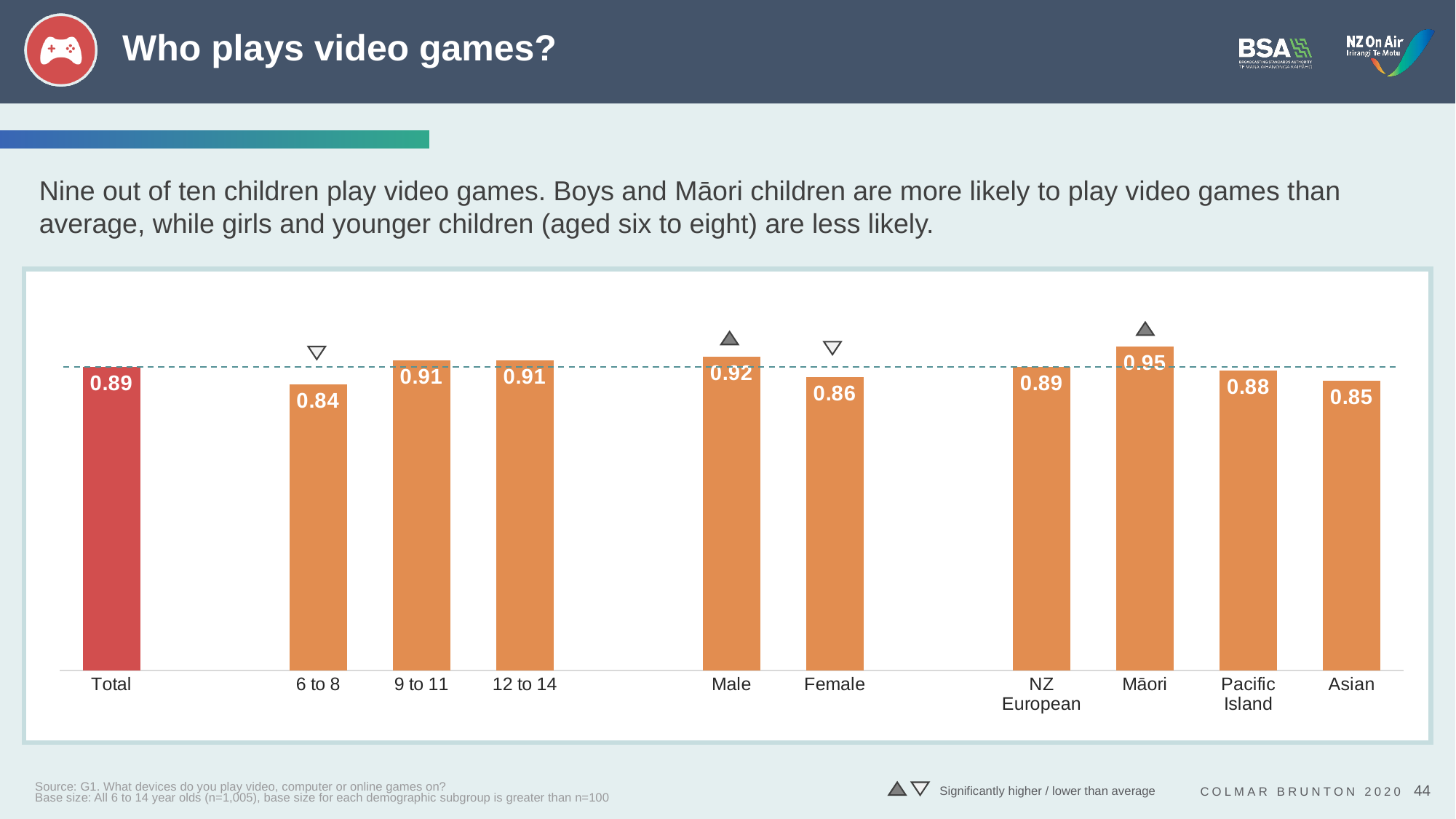
What is the value for 6 to 8? 0.84 What kind of chart is shown on the slide? Bar chart What is the value for Female? 0.86 What is the value for Total? 0.89 What is the value for Pacific Island? 0.88 Which category has the lowest value? 6 to 8 How many categories are shown on the x axis? 10 Which category has the highest value? Māori What is the difference between the values for Māori and Asian? 0.10 What is the difference between the values for Male and Female? 0.06 Which bar is coloured red rather than orange? Total Which is larger, the value for 9 to 11 or the value for 6 to 8? 9 to 11